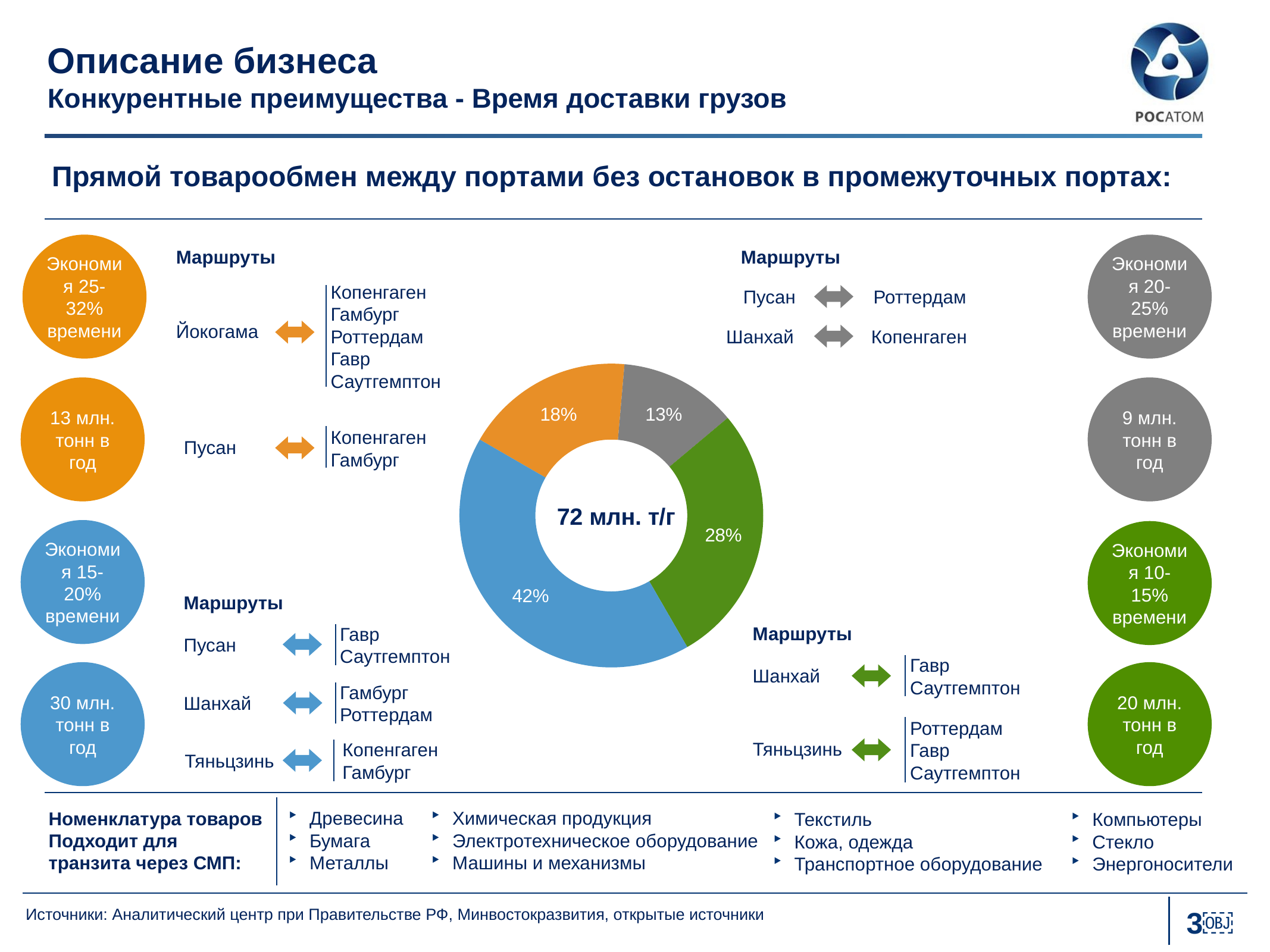
Which slice of the donut chart is the largest? The blue slice (42%) What kind of chart is shown in the centre of the slide? Donut (pie) chart What text is shown in the centre of the donut chart? 72 млн. т/г Which slice of the donut chart is the smallest? The grey slice (13%) What is the combined share of the orange and grey slices in the donut chart? 31% What value is shown on the blue slice of the donut chart? 42% What value is shown on the grey slice of the donut chart? 13% How many slices does the donut chart have? 4 What value is shown on the orange slice of the donut chart? 18% What is the difference between the blue slice and the green slice in the donut chart? 14% Which is larger in the donut chart, the orange slice or the grey slice? The orange slice (18%) What value is shown on the green slice of the donut chart? 28%